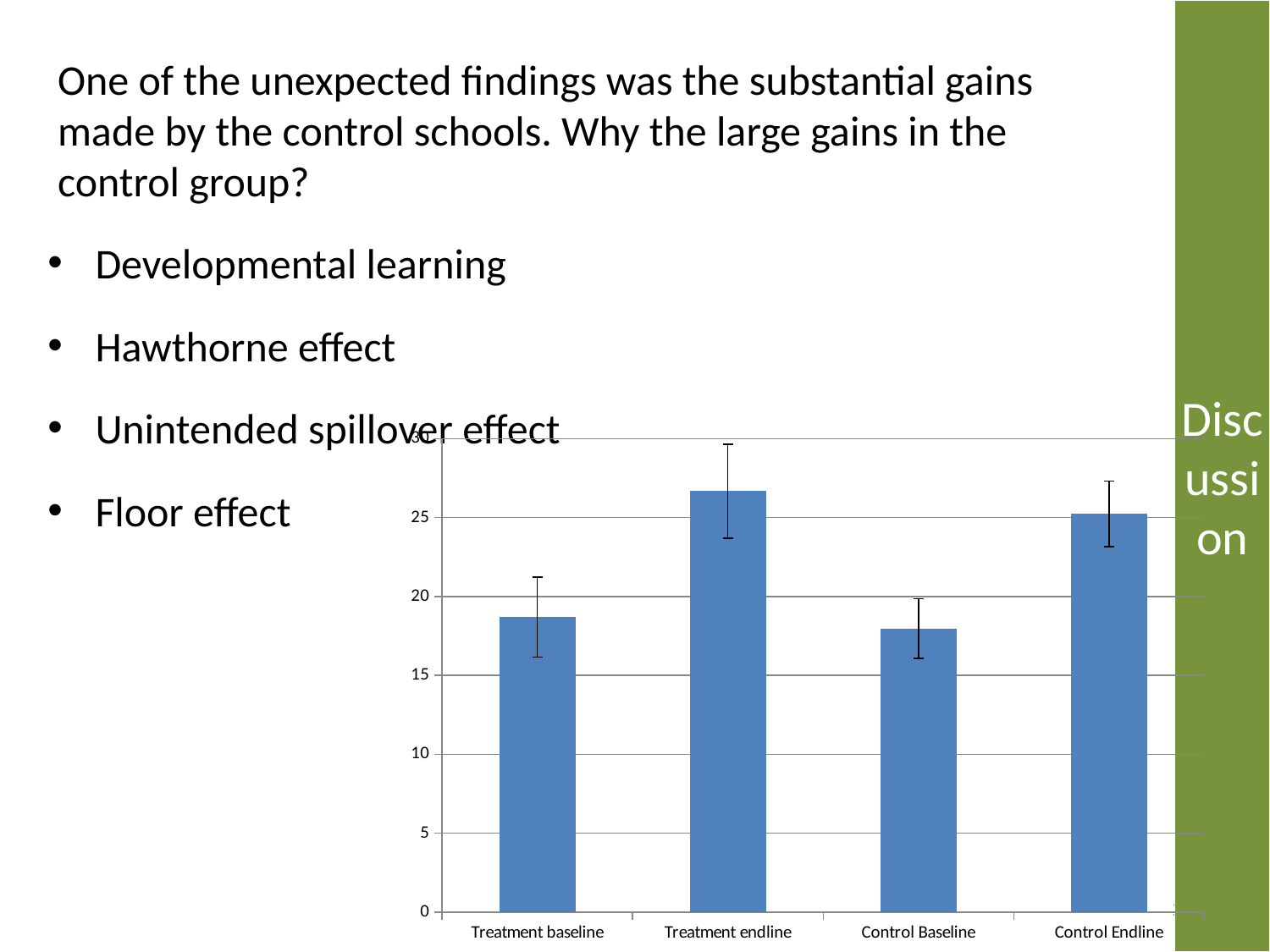
Which is larger, the value for Control Endline or the value for Control Baseline? Control Endline Which is larger, the value for Treatment endline or the value for Control Endline? Treatment endline Is the value for Control Endline greater or less than 20? greater Is the value for Treatment baseline greater or less than 20? less Is the value for Treatment endline greater or less than 25? greater Which is larger, the value for Treatment endline or the value for Treatment baseline? Treatment endline What is the highest tick value shown on the y axis of the chart? 30 What kind of chart is shown on the slide? bar chart What colour are the bars in the chart? blue How many categories are plotted on the x axis of the chart? 4 Which category has the highest bar in the chart? Treatment endline